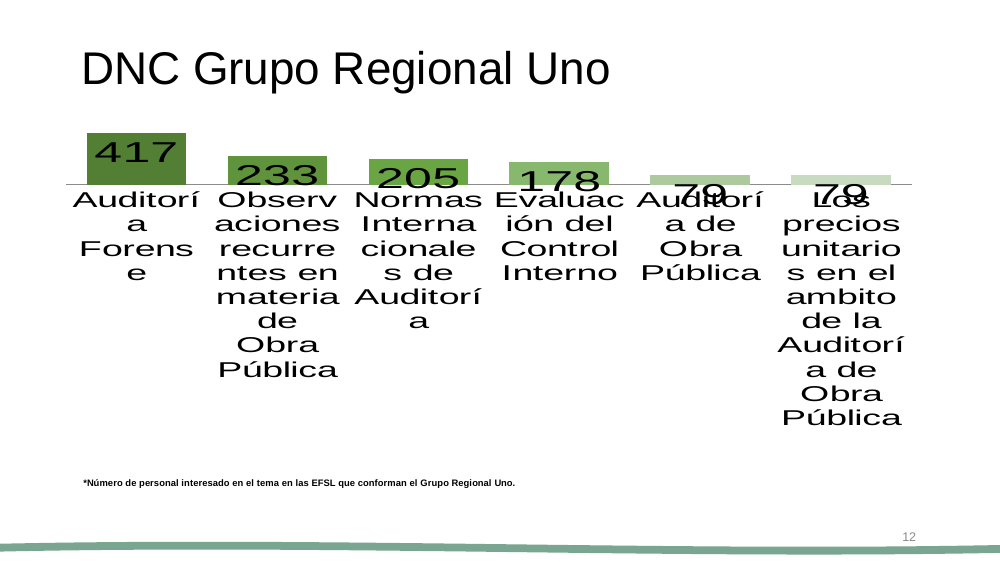
What is the title of the slide containing the chart? DNC Grupo Regional Uno How many categories are shown in the chart? 6 What is the value for Observaciones recurrentes en materia de Obra Pública? 233 Which category has the highest value? Auditoría Forense Which is larger, the value for Observaciones recurrentes en materia de Obra Pública or the value for Evaluación del Control Interno? Observaciones recurrentes en materia de Obra Pública What is the value for Evaluación del Control Interno? 178 Do the values rise or fall from left to right across the categories? Fall What is the difference between the values for Auditoría Forense and Observaciones recurrentes en materia de Obra Pública? 184 What is the value for Auditoría Forense? 417 What is the difference between the values for Normas Internacionales de Auditoría and Evaluación del Control Interno? 27 What kind of chart is shown on the slide? Bar chart What is the value for Normas Internacionales de Auditoría? 205